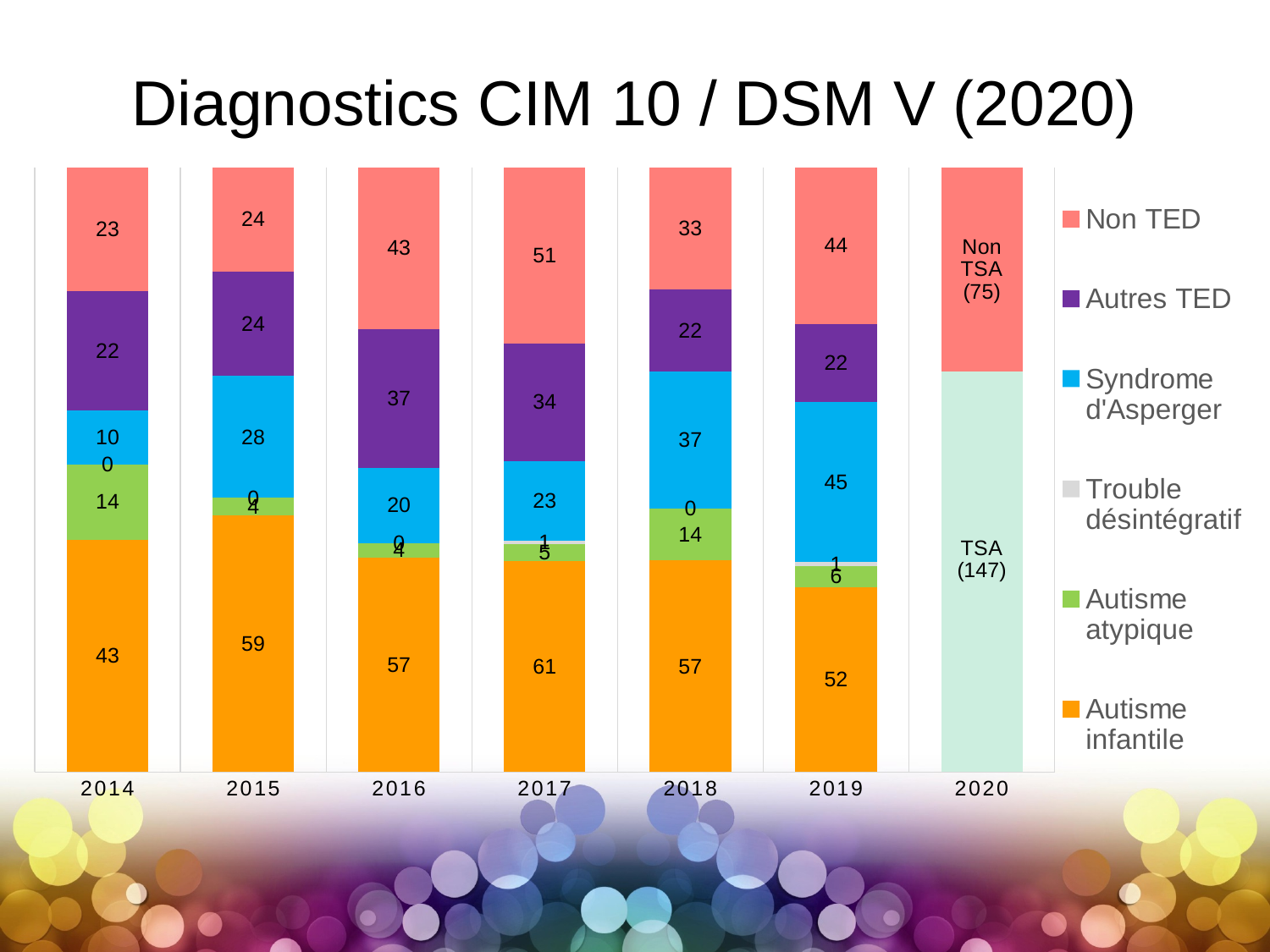
What is the TSA value shown in the 2020 bar? 147 What is the value for Autres TED in 2018? 22 What is the difference between the Autisme infantile values for 2017 and 2014? 18 What kind of chart is shown on the slide? Stacked bar chart What is the total of the 2014 stacked bar? 112 Which year has the larger Syndrome d'Asperger value, 2016 or 2018? 2018 What is the value for Autisme infantile in 2014? 43 What is the value for Syndrome d'Asperger in 2019? 45 How many series does the legend list? 6 How many years are shown along the x axis? 7 What is the value for Non TED in 2017? 51